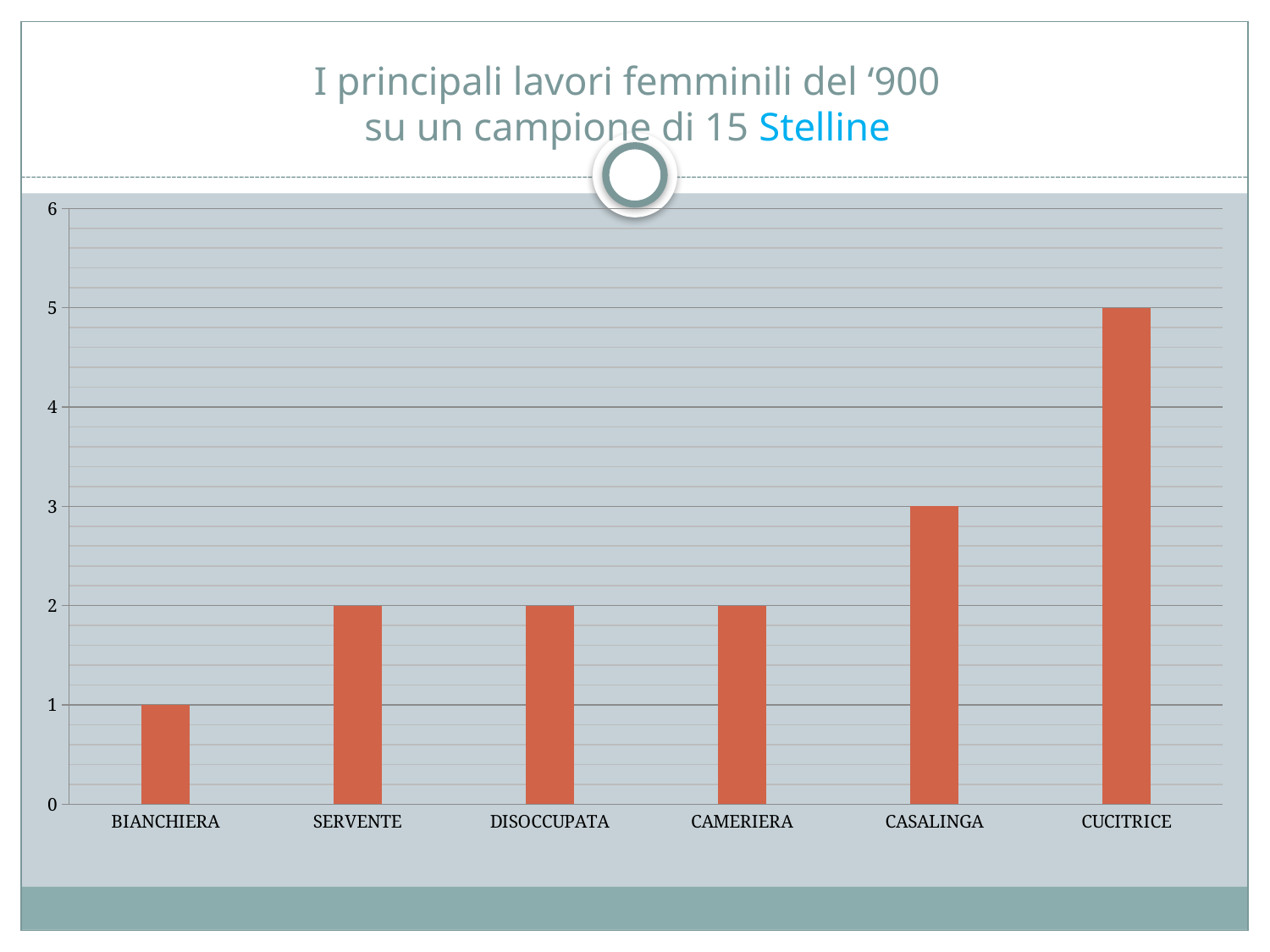
Which category has the lowest value? BIANCHIERA What kind of chart is shown on the slide? bar chart Is the value for CUCITRICE greater or less than 4? greater What is the value for BIANCHIERA? 1 Which category has the highest value? CUCITRICE What is the value for CASALINGA? 3 What is the difference between the values for CUCITRICE and CASALINGA? 2 How many categories are shown on the x axis of the chart? 6 What is the title of the slide containing the chart? I principali lavori femminili del '900 su un campione di 15 Stelline Which is larger, the value for CASALINGA or the value for CAMERIERA? CASALINGA What is the value for CUCITRICE? 5 What is the value for SERVENTE? 2